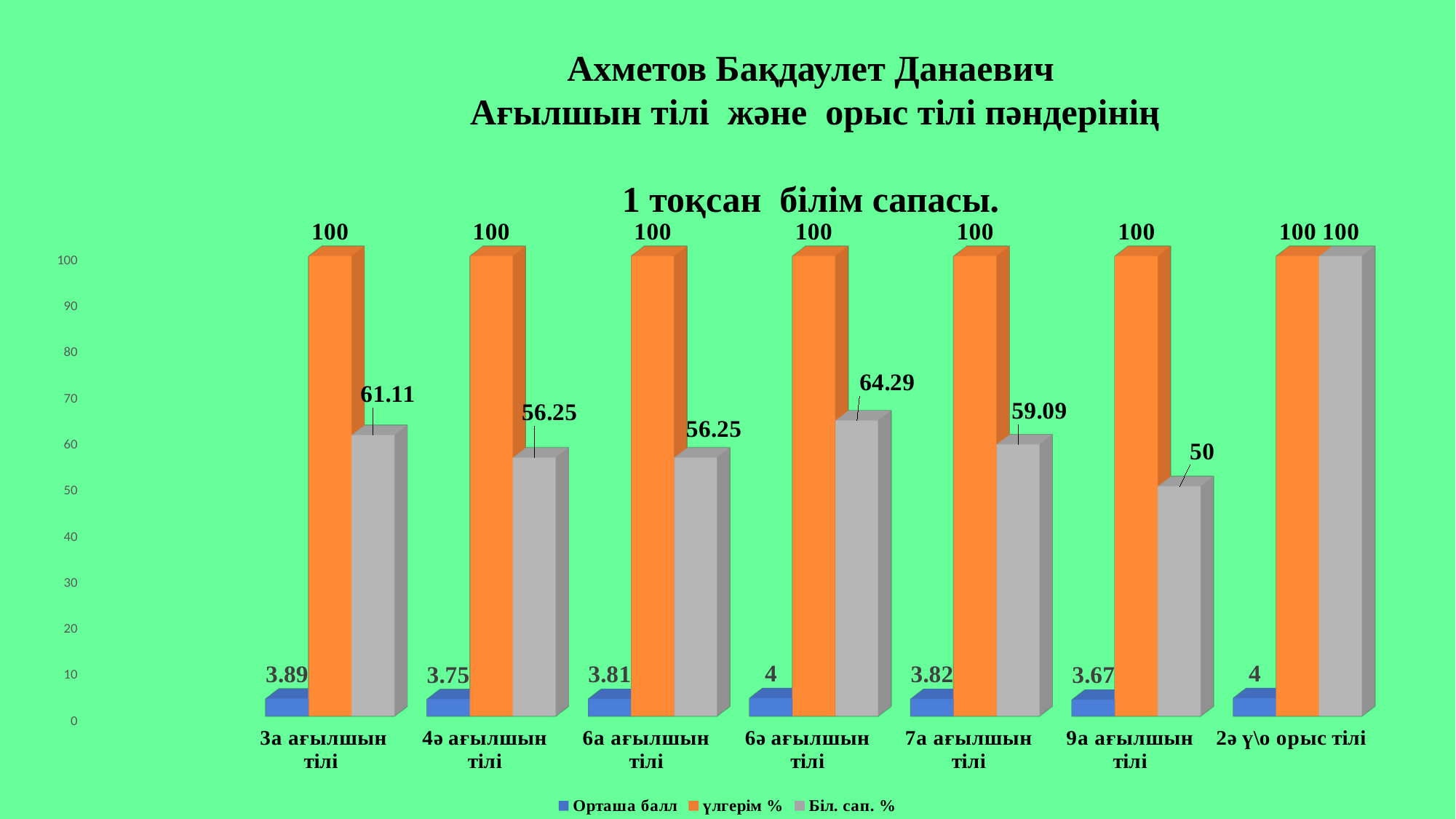
What is the difference between the Біл. сап. % values for 6ә ағылшын тілі and 9а ағылшын тілі? 14.29 What is the Орташа балл value for 9а ағылшын тілі? 3.67 Which category has the lowest Біл. сап. % value? 9а ағылшын тілі What is the Біл. сап. % value for 2ә у\о орыс тілі? 100 How many categories are shown on the x axis? 7 What is the Біл. сап. % value for 3а ағылшын тілі? 61.11 What kind of chart is shown on the slide? Bar chart Which is larger, the Біл. сап. % value for 3а ағылшын тілі or for 7а ағылшын тілі? 3а ағылшын тілі How many series does the legend list? 3 What is the үлгерім % value for 7а ағылшын тілі? 100 Which series is shown in orange in the legend? үлгерім % Which category has the lowest Орташа балл value? 9а ағылшын тілі